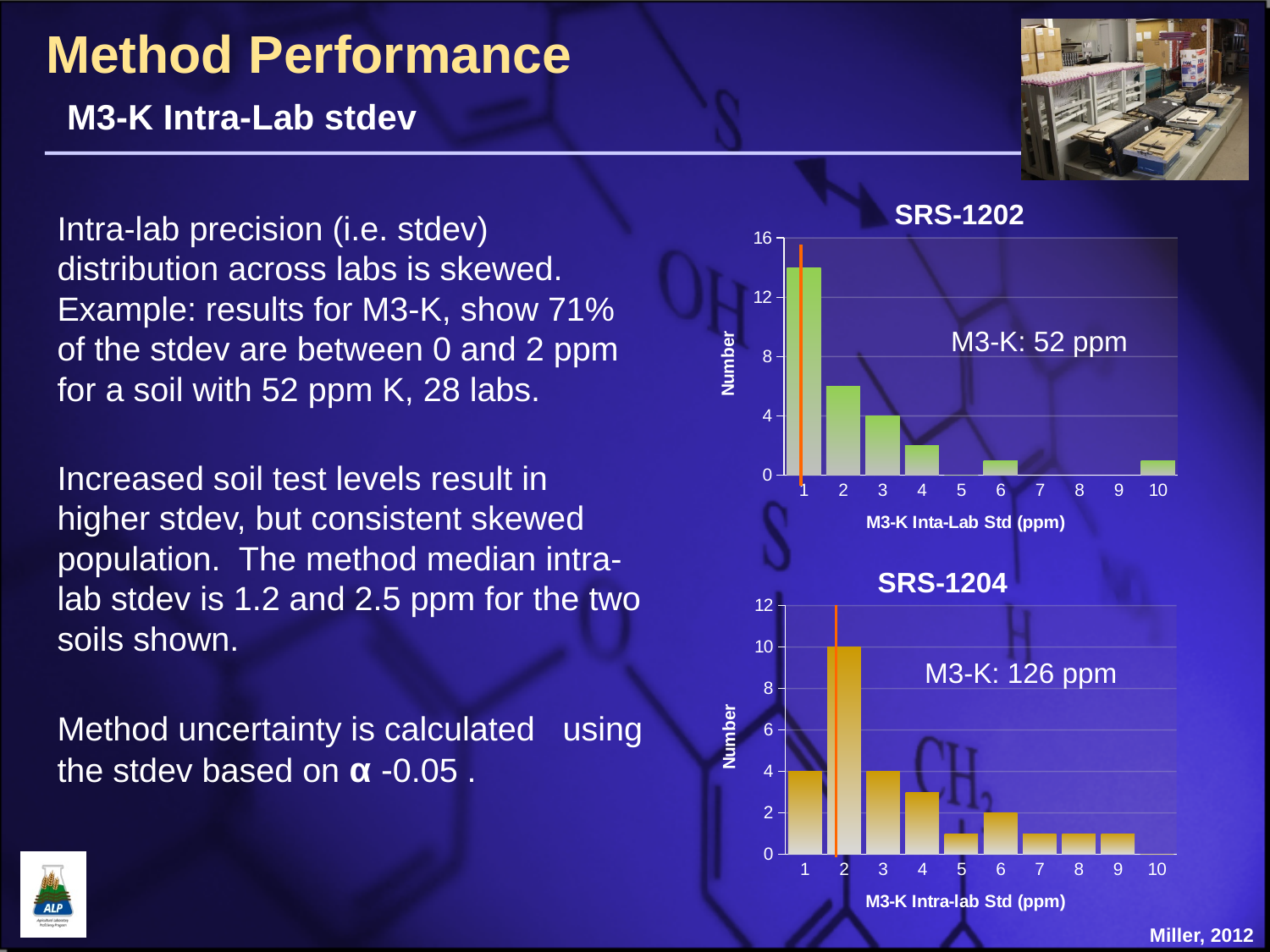
What is the y-axis title of the SRS-1202 chart? Number In the SRS-1204 chart, which has the larger Number, category 2 or category 3? category 2 In the SRS-1204 chart, what is the Number for category 2? 10 How many categories are shown on the x axis of the SRS-1202 chart? 10 In the SRS-1202 chart, do the values rise or fall from category 1 to category 4? fall In the SRS-1202 chart, is the Number for category 2 greater or less than 8? less In the SRS-1204 chart, which M3-K Intra-lab Std (ppm) category has the highest Number? 2 In the SRS-1204 chart, is the Number for category 4 greater or less than 2? greater What kind of chart is the SRS-1202 chart? bar chart In the SRS-1202 chart, which M3-K Inta-Lab Std (ppm) category has the highest Number? 1 In the SRS-1202 chart, is the Number for category 1 greater or less than 12? greater What is the x-axis title of the SRS-1204 chart? M3-K Intra-lab Std (ppm)